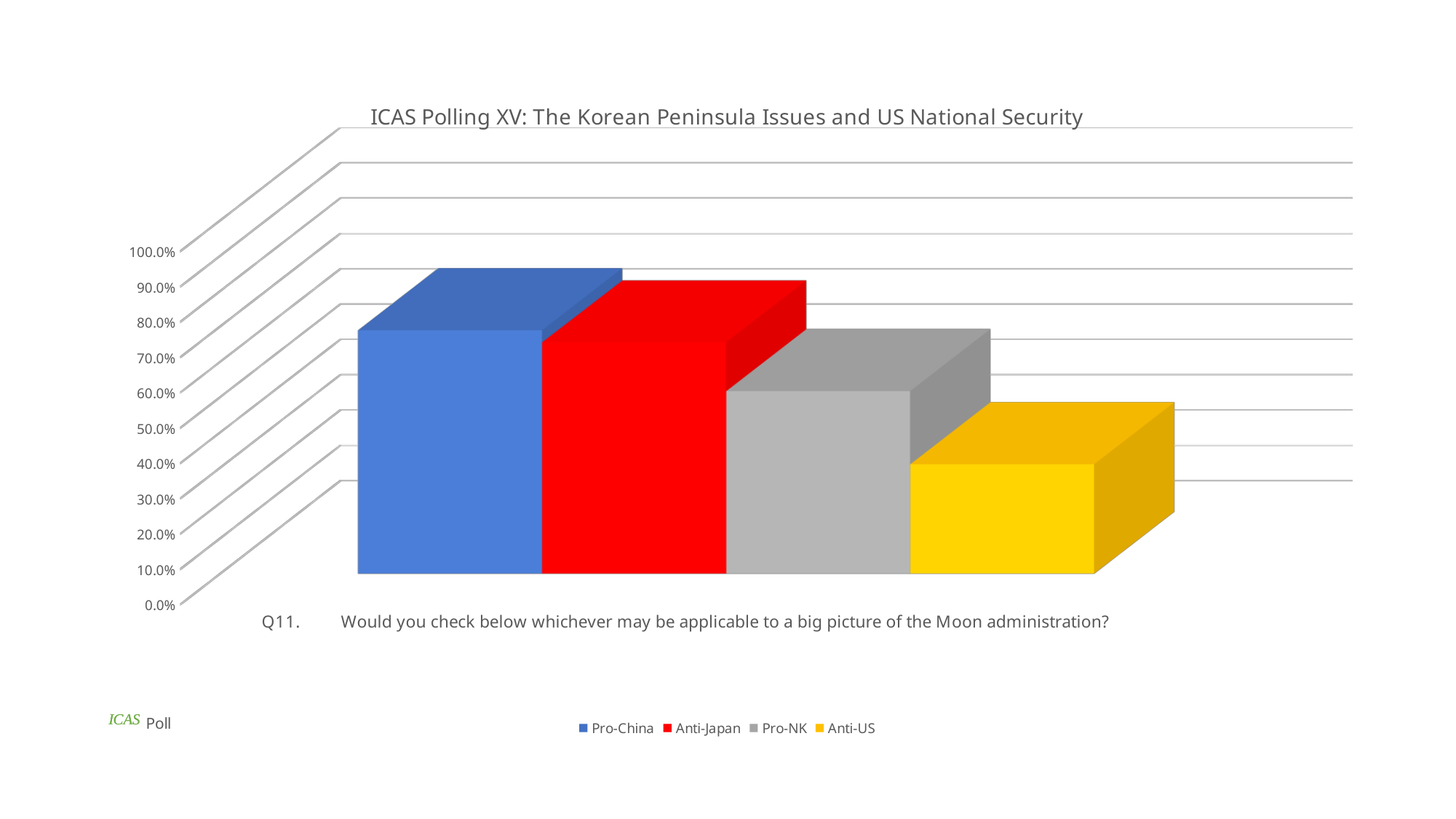
Which is larger, the value for Pro-NK or the value for Anti-US? Pro-NK Which series is shown in yellow? Anti-US Is the value for Anti-US greater or less than 50.0%? less What is the title of the chart? ICAS Polling XV: The Korean Peninsula Issues and US National Security How many bars are plotted in the chart? 4 Is the value for Anti-US greater or less than 10.0%? greater How many series does the legend list? 4 Which series has the lowest value? Anti-US What kind of chart is shown on the slide? bar chart Is the value for Pro-China greater or less than 40.0%? greater Which is larger, the value for Anti-Japan or the value for Pro-NK? Anti-Japan Which series has the highest value? Pro-China